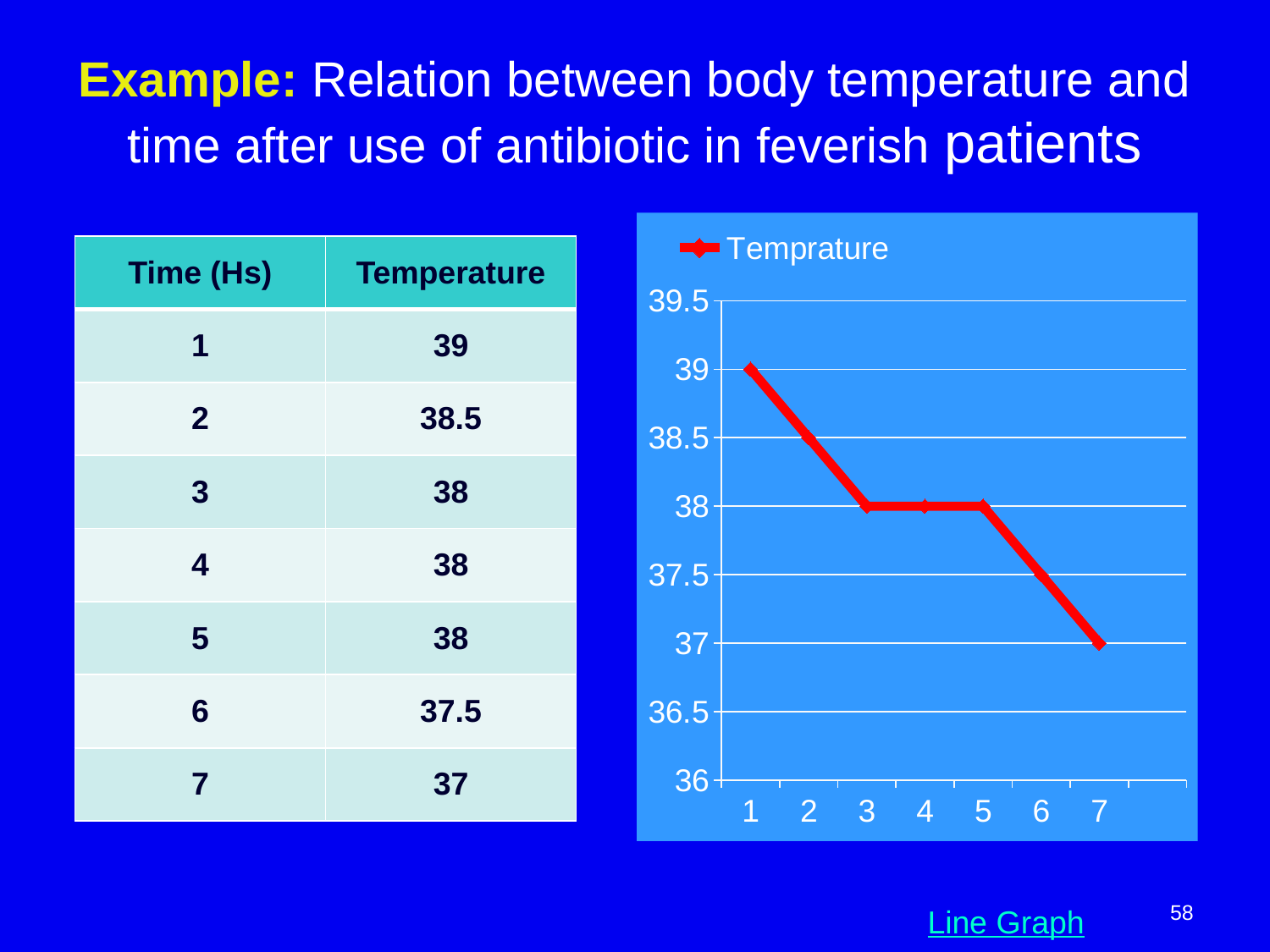
At which time is the temperature highest? 1 Which is larger, the temperature at time 2 or at time 6? time 2 How many time points are plotted on the chart? 7 At which time is the temperature lowest? 7 What kind of chart is shown on the slide? line chart What is the temperature at time 4 on the chart? 38 What is the difference between the temperature at time 1 and at time 7? 2 What is the temperature at time 6 on the chart? 37.5 What series name does the chart legend show? Temprature Do the temperature values rise or fall as time increases along the x axis? fall What is the temperature at time 1 on the chart? 39 What is the temperature at time 7 on the chart? 37